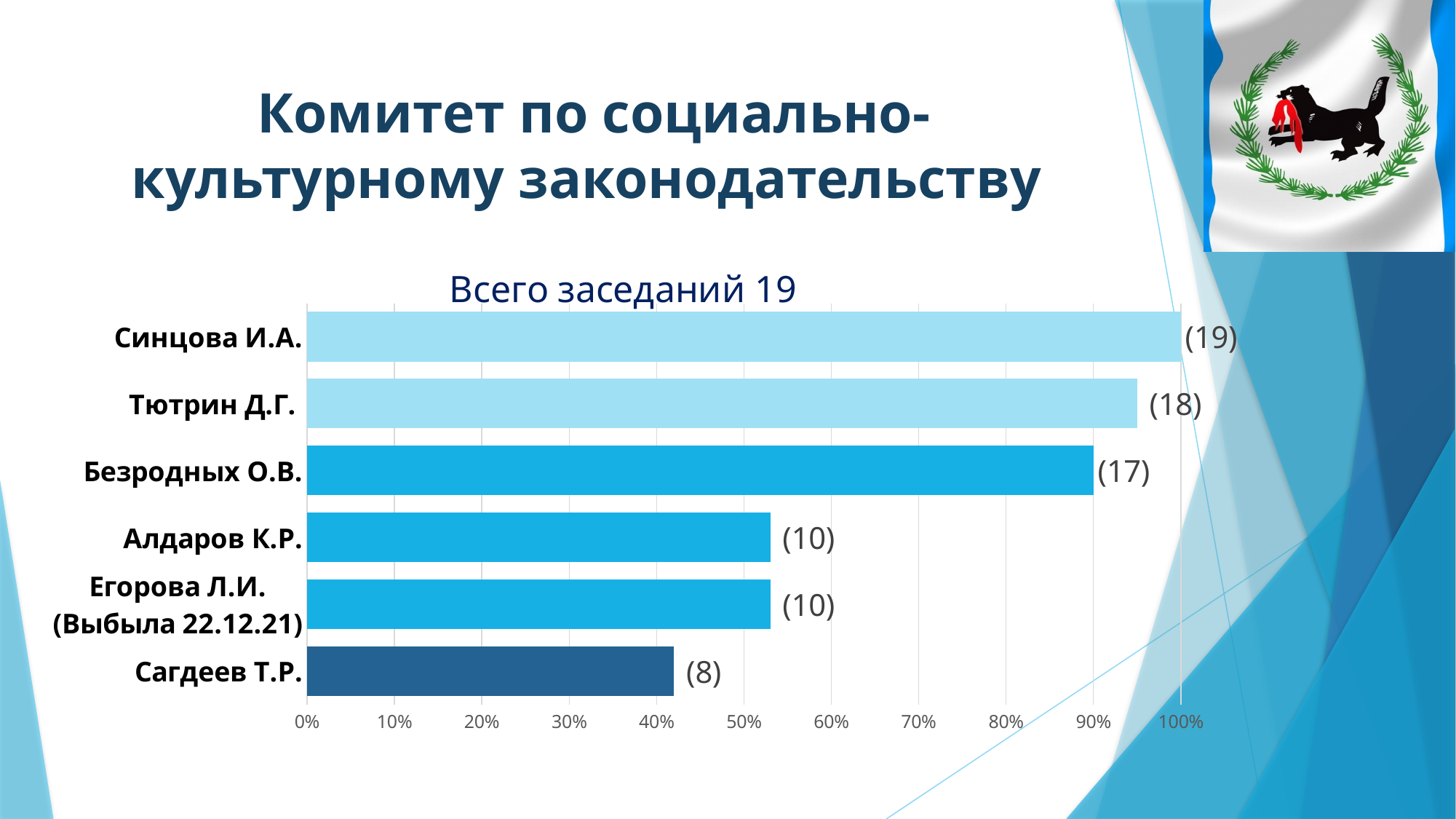
What kind of chart is shown on the slide? bar chart How many categories are shown in the chart? 6 What is the title of the chart? Всего заседаний 19 Which category has the highest value? Синцова И.А. Is the bar for Сагдеев Т.Р. greater or less than 50%? less Which is larger, the value for Тютрин Д.Г. or the value for Безродных О.В.? Тютрин Д.Г. What is the value shown for Сагдеев Т.Р.? (8) Which category has the lowest value? Сагдеев Т.Р. What is the value shown for Синцова И.А.? (19) What is the value shown for Безродных О.В.? (17) Is the bar for Тютрин Д.Г. greater or less than 90%? greater What is the difference between the values for Синцова И.А. and Сагдеев Т.Р.? 11